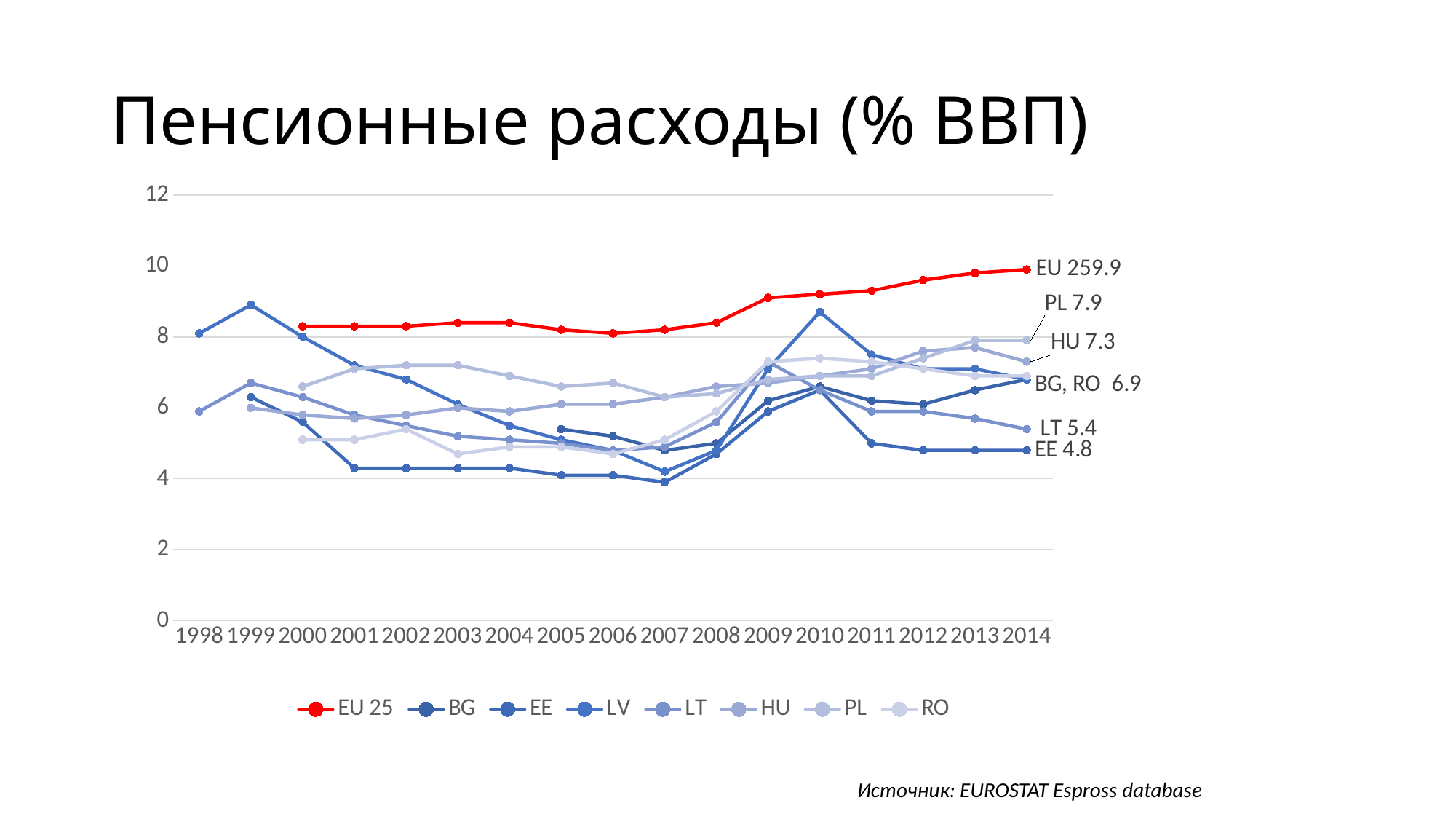
What is the value labelled for HU at the end of the series in 2014? 7.3 What is the value labelled for EE at the end of the series in 2014? 4.8 Is the value for EU 25 in 2014 greater or less than 8? greater What kind of chart is shown on the slide? line chart How many years are shown on the x axis? 17 What is the difference between the 2014 values labelled for PL and EE? 3.1 What is the title of the chart? Пенсионные расходы (% ВВП) What is the value labelled for PL at the end of the series in 2014? 7.9 What is the value labelled for LT at the end of the series in 2014? 5.4 How many series does the legend list? 8 Does the EU 25 line rise or fall from 2009 to 2014? rise Which series has the lowest value in 2014? EE